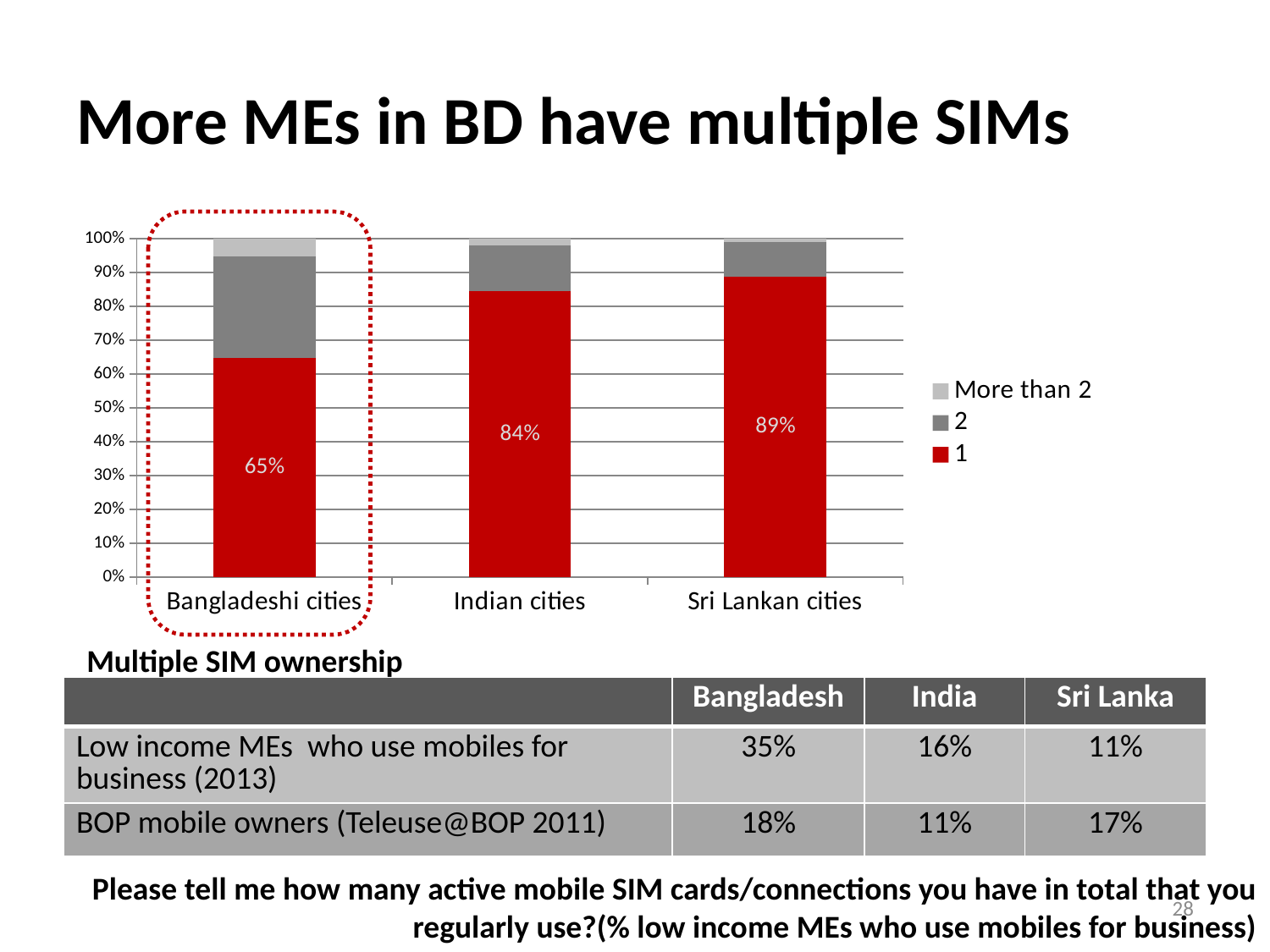
How many city groups are shown on the x axis of the chart? 3 How many series does the chart legend list? 3 Which city group has the highest share of MEs with 1 SIM card? Sri Lankan cities What is the difference between the share of MEs with 1 SIM in Sri Lankan cities and in Bangladeshi cities? 24% Is the share of MEs with 2 SIMs in Bangladeshi cities greater or less than 20%? greater What percentage of low income MEs in Sri Lankan cities have 1 SIM card? 89% What percentage of low income MEs in Bangladeshi cities have 1 SIM card? 65% What type of chart is shown on the slide? Stacked bar chart What percentage of low income MEs in Indian cities have 1 SIM card? 84% Is the share of MEs with 2 SIMs in Sri Lankan cities greater or less than 20%? less Which is larger: the share of MEs with 1 SIM in Indian cities or in Sri Lankan cities? Sri Lankan cities Which city group has the lowest share of MEs with 1 SIM card? Bangladeshi cities